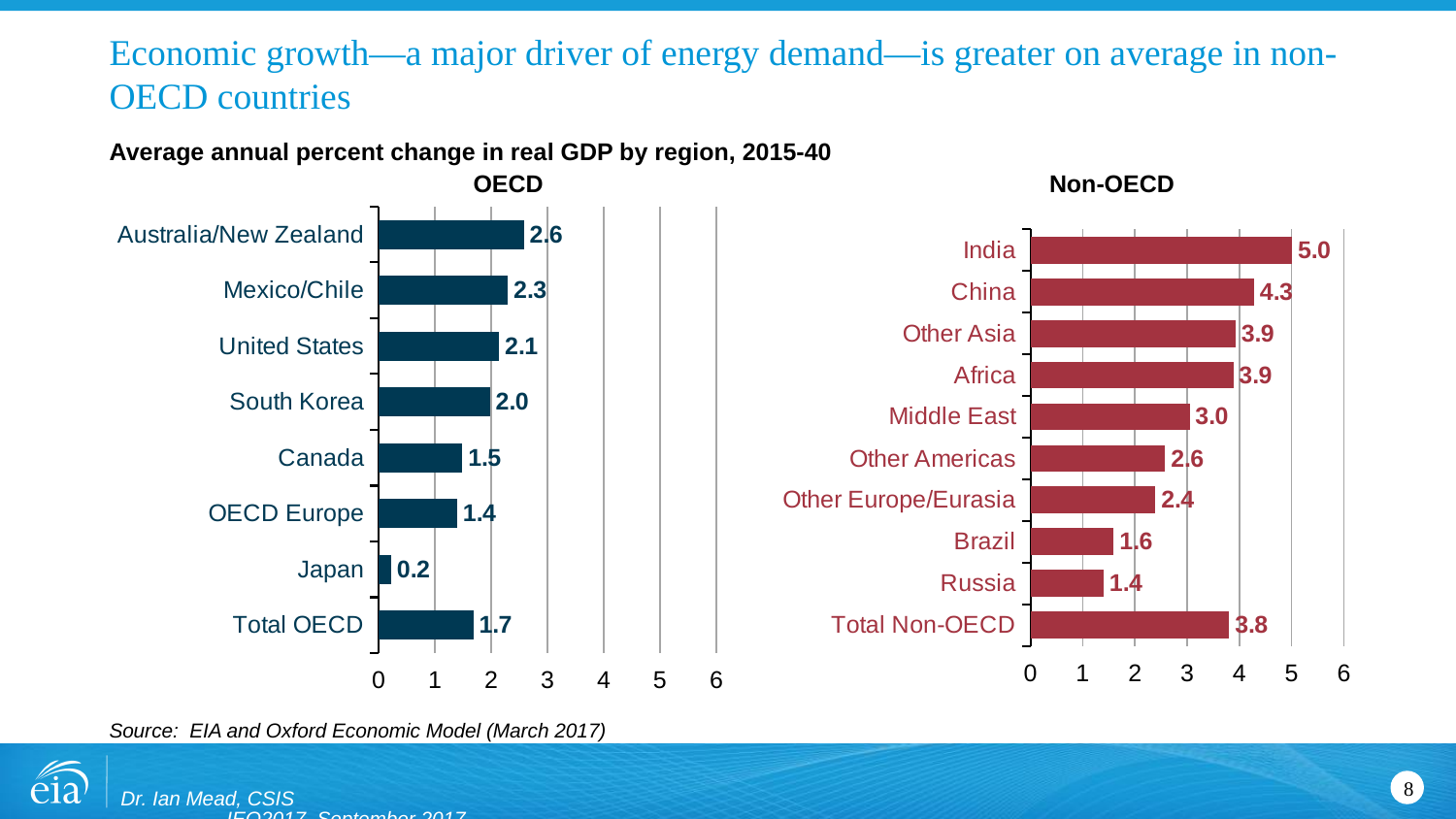
What is the value for Total Non-OECD in the Non-OECD chart? 3.8 In the Non-OECD chart, what is the difference between India and Russia? 3.6 How many categories are shown in the Non-OECD chart? 10 In the Non-OECD chart, which is larger, Middle East or Brazil? Middle East What kind of chart is the OECD chart? Bar chart In the OECD chart, is the value for Mexico/Chile greater or less than 2? greater In the Non-OECD chart, what is the value for China? 4.3 In the Non-OECD chart, which region has the highest value? India How many categories are shown in the OECD chart? 8 In the OECD chart, what is the difference between Australia/New Zealand and Japan? 2.4 In the OECD chart, what is the value for the United States? 2.1 In the OECD chart, which category has the lowest value? Japan